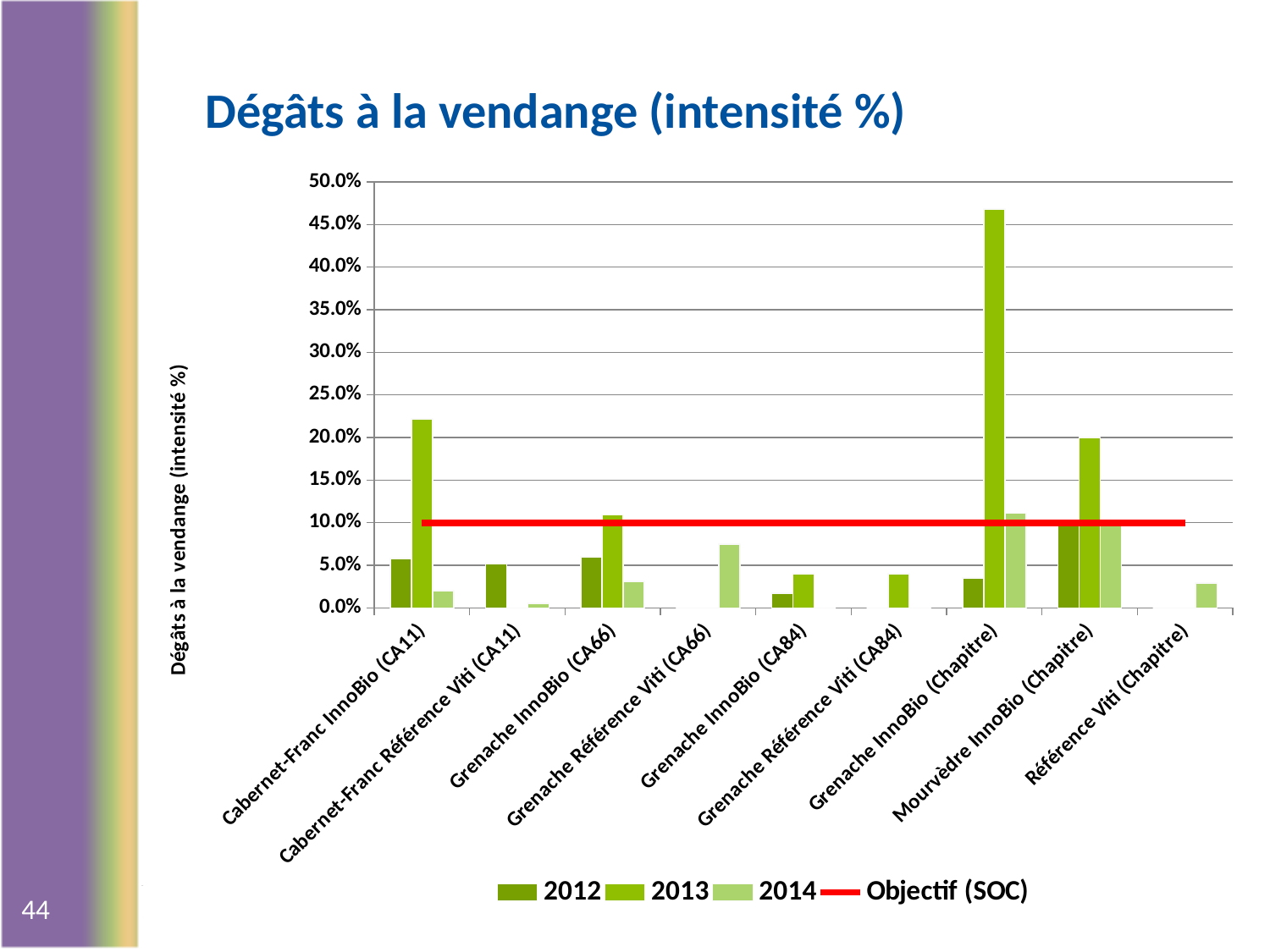
For Cabernet-Franc InnoBio (CA11), which year has the larger value, 2012 or 2013? 2013 How many entries does the chart's legend list? 4 Is the 2013 value for Grenache InnoBio (Chapitre) greater or less than 45.0%? greater How many categories are shown along the x axis of the chart? 9 Which is larger, the 2013 value for Grenache InnoBio (Chapitre) or the 2013 value for Mourvèdre InnoBio (Chapitre)? Grenache InnoBio (Chapitre) What is the title of the chart on the slide? Dégâts à la vendange (intensité %) Is the 2014 value for Référence Viti (Chapitre) greater or less than 5.0%? less Is the 2014 value for Grenache Référence Viti (CA66) greater or less than 5.0%? greater Which category has the highest 2013 value in the chart? Grenache InnoBio (Chapitre) What kind of chart is shown on the slide? bar chart